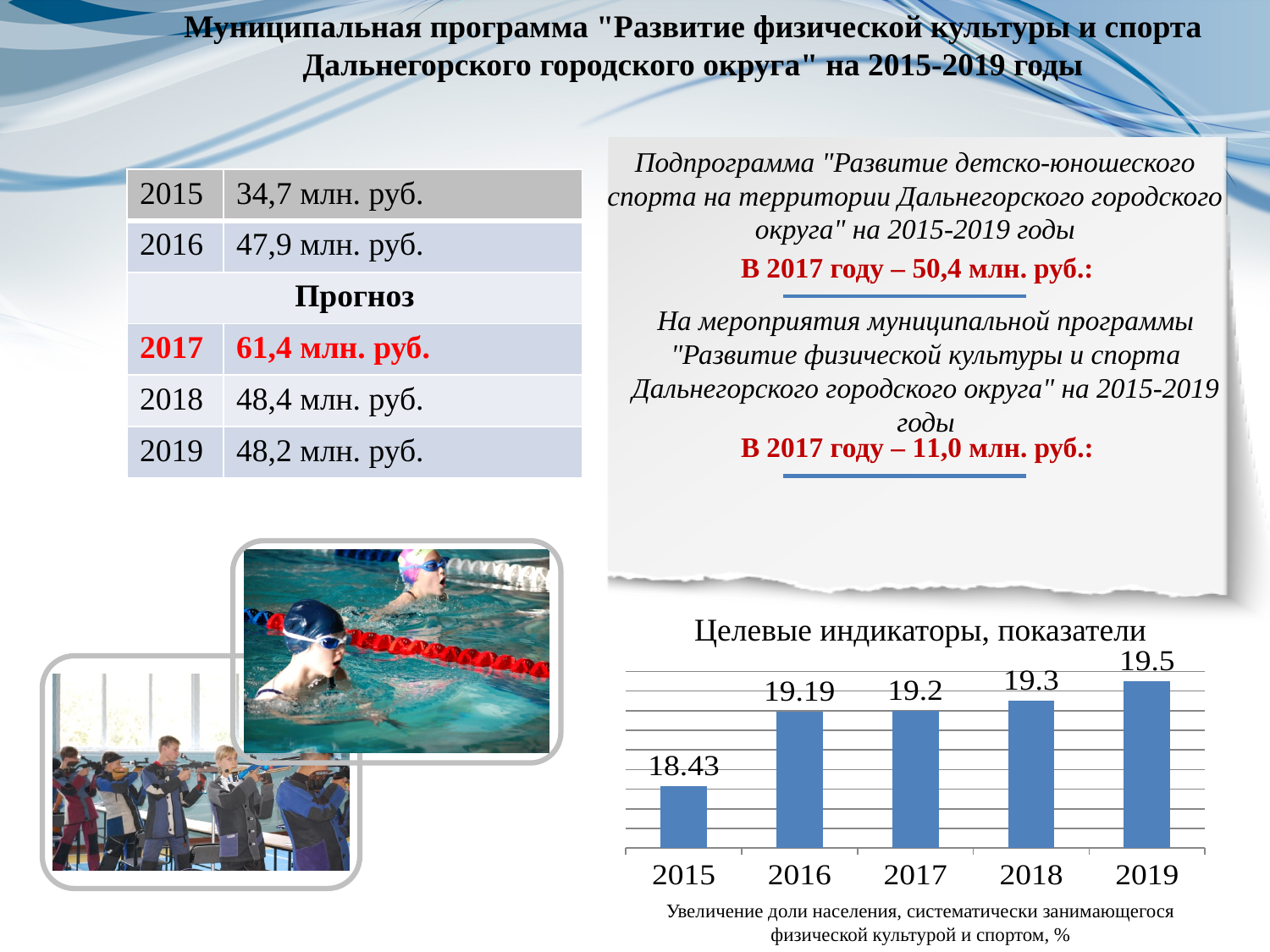
What is the value for 2016 in the chart "Целевые индикаторы, показатели"? 19.19 What type of chart is shown under the title "Целевые индикаторы, показатели"? bar chart What is the value for 2019 in the chart "Целевые индикаторы, показатели"? 19.5 What is the value for 2017 in the chart "Целевые индикаторы, показатели"? 19.2 In the chart "Целевые индикаторы, показатели", what is the difference between the values for 2019 and 2015? 1.07 What is the value for 2015 in the chart "Целевые индикаторы, показатели"? 18.43 How many years (categories) are shown in the chart "Целевые индикаторы, показатели"? 5 Which year has the highest value in the chart "Целевые индикаторы, показатели"? 2019 In the chart "Целевые индикаторы, показатели", what is the difference between the values for 2018 and 2017? 0.1 Which year has the lowest value in the chart "Целевые индикаторы, показатели"? 2015 In the chart "Целевые индикаторы, показатели", which is larger: the value for 2016 or the value for 2015? 2016 Do the values in the chart "Целевые индикаторы, показатели" rise or fall from 2015 to 2019? rise